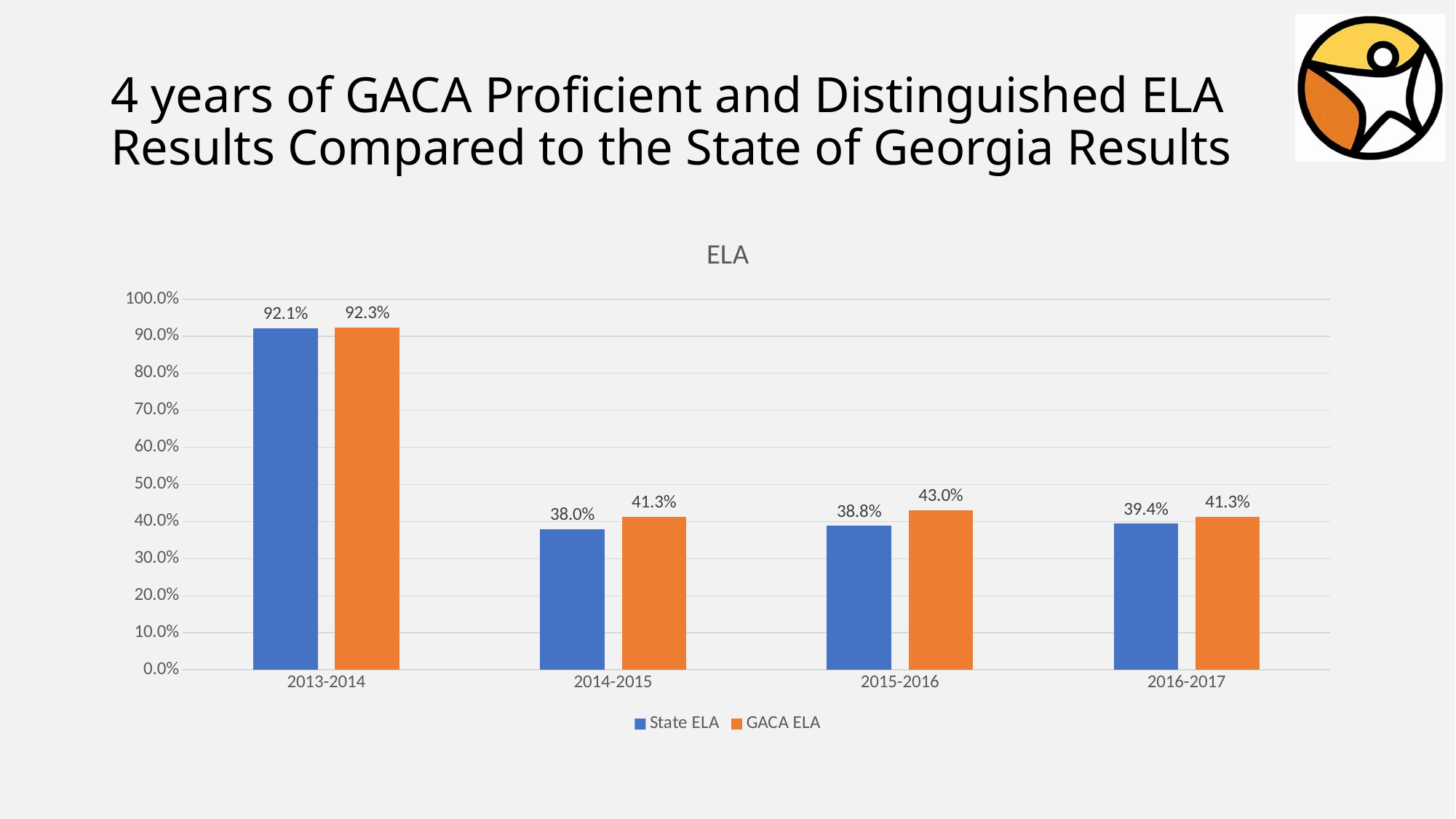
What kind of chart is shown on the slide? Bar chart Is the State ELA value for 2013-2014 greater or less than 80.0%? greater What is the difference between the GACA ELA and State ELA values for 2015-2016? 4.2% What is the GACA ELA value for 2015-2016? 43.0% Which is larger in 2014-2015, State ELA or GACA ELA? GACA ELA How many series does the legend list? 2 What is the GACA ELA value for 2013-2014? 92.3% What is the State ELA value for 2016-2017? 39.4% How many school years are shown on the x axis? 4 Which year has the highest State ELA value? 2013-2014 What is the State ELA value for 2014-2015? 38.0%